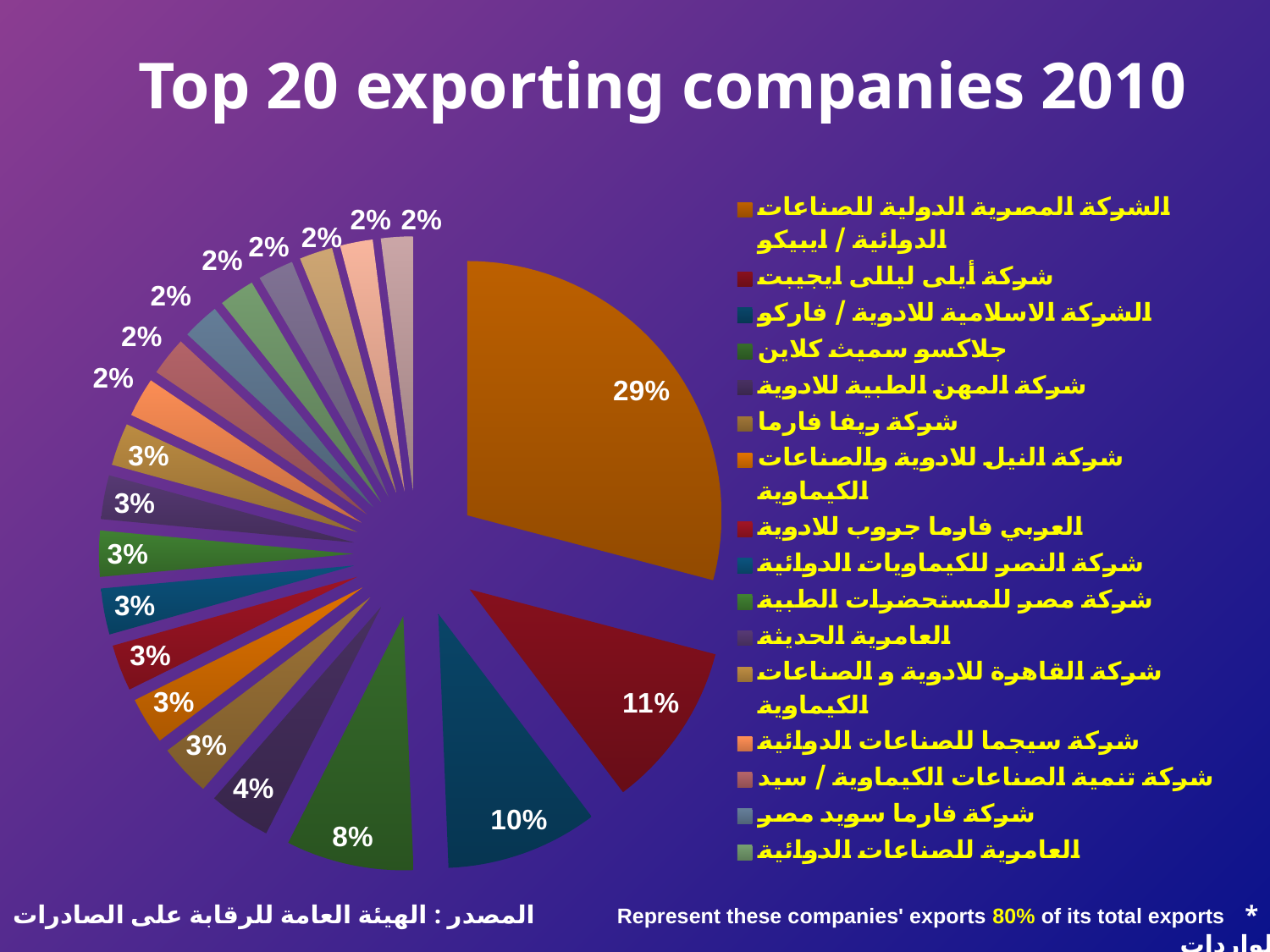
What is the combined share of the three largest slices (29%, 11% and 10%)? 50% How many slices in the pie chart are labelled 3%? 7 What is the smallest share shown as a data label in the pie chart? 2% What is the difference in percentage points between the largest slice (29%) and the second-largest slice (11%)? 18 percentage points What is the title of the chart? Top 20 exporting companies 2010 What is the share of the largest slice in the pie chart? 29% Which is larger: the slice labelled 10% or the slice labelled 8%? 10% Which company does the largest slice (29%) of the pie chart represent? الشركة المصرية الدولية للصناعات الدوائية / ايبيكو How many slices in the pie chart are labelled 2%? 8 What type of chart is shown on the slide? pie chart How many slices does the pie chart have? 20 What is the share of the second-largest slice in the pie chart? 11%